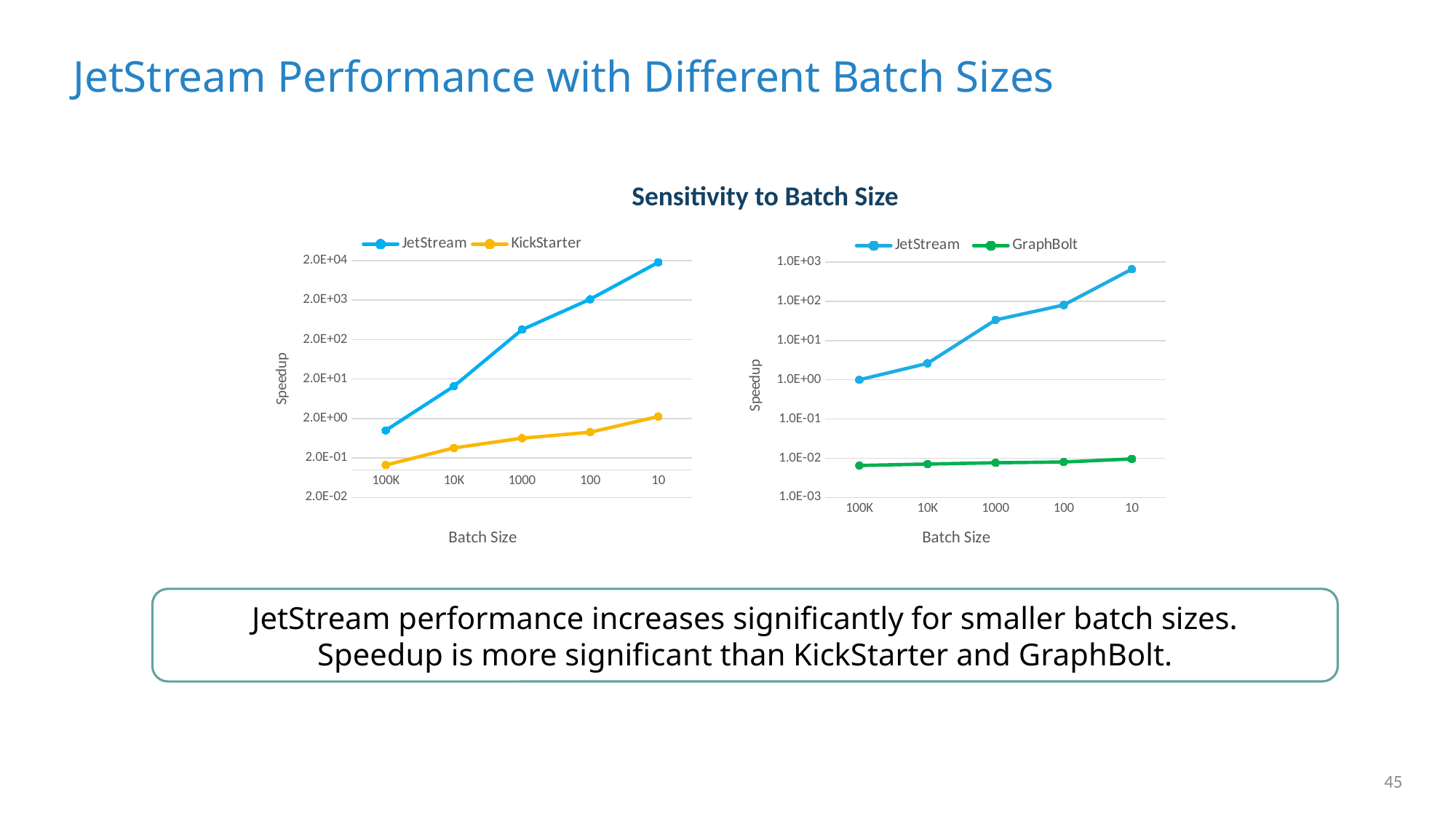
In the right chart, is the JetStream speedup at batch size 10 greater or less than 1.0E+02? greater In the right chart, which series has the larger speedup at batch size 100K, JetStream or GraphBolt? JetStream In the left chart, is the JetStream speedup at batch size 100K greater or less than 2.0E+00? less In the right chart, does the GraphBolt line rise or fall along the x axis from batch size 100K to 10? rise In the left chart, does the JetStream line rise or fall along the x axis from batch size 100K to 10? rise In the right chart, is the GraphBolt speedup at batch size 100K greater or less than 1.0E-02? less In the left chart, which series has the larger speedup at batch size 10, JetStream or KickStarter? JetStream How many series does the legend of the right chart (JetStream vs GraphBolt) list? 2 What is the x-axis label of the right chart? Batch Size How many batch sizes are plotted along the x axis of the left chart? 5 What kind of chart is the left chart (JetStream vs KickStarter)? line chart What is the shared title shown above the two charts? Sensitivity to Batch Size